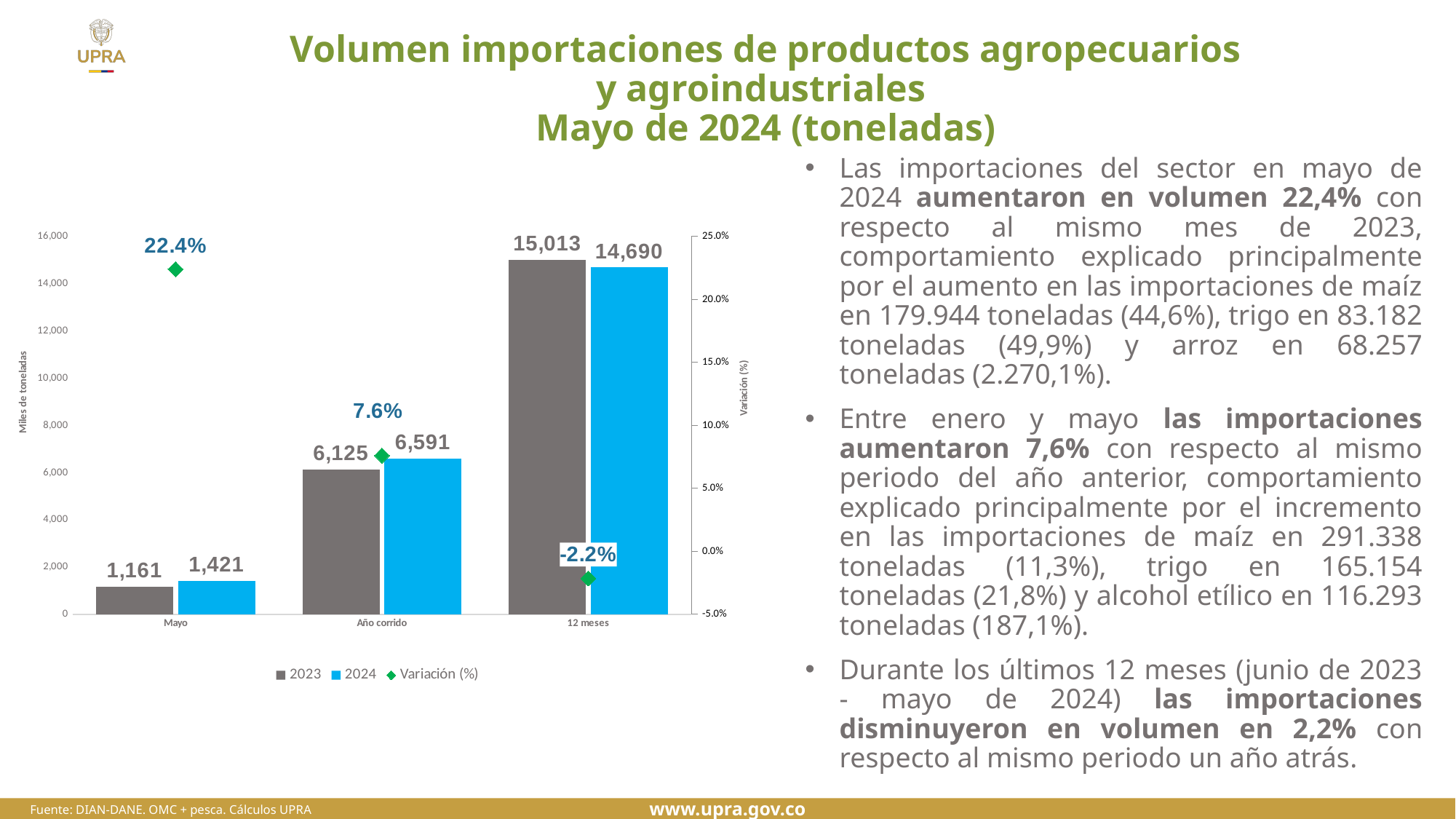
What is the Variación (%) value for Mayo? 22.4% Which category has the lowest 2023 value? Mayo What is the Variación (%) value for 12 meses? -2.2% How many series does the legend list? 3 What is the 2023 value for Año corrido? 6,125 What is the 2024 value for Mayo? 1,421 Which is larger for Año corrido, the 2023 value or the 2024 value? 2024 What is the label of the left vertical axis? Miles de toneladas How many categories are shown on the x axis? 3 What kind of chart is used for the 2023 and 2024 series? bar chart What is the difference between the 2023 and 2024 values for 12 meses? 323 Which category has the highest 2024 value? 12 meses